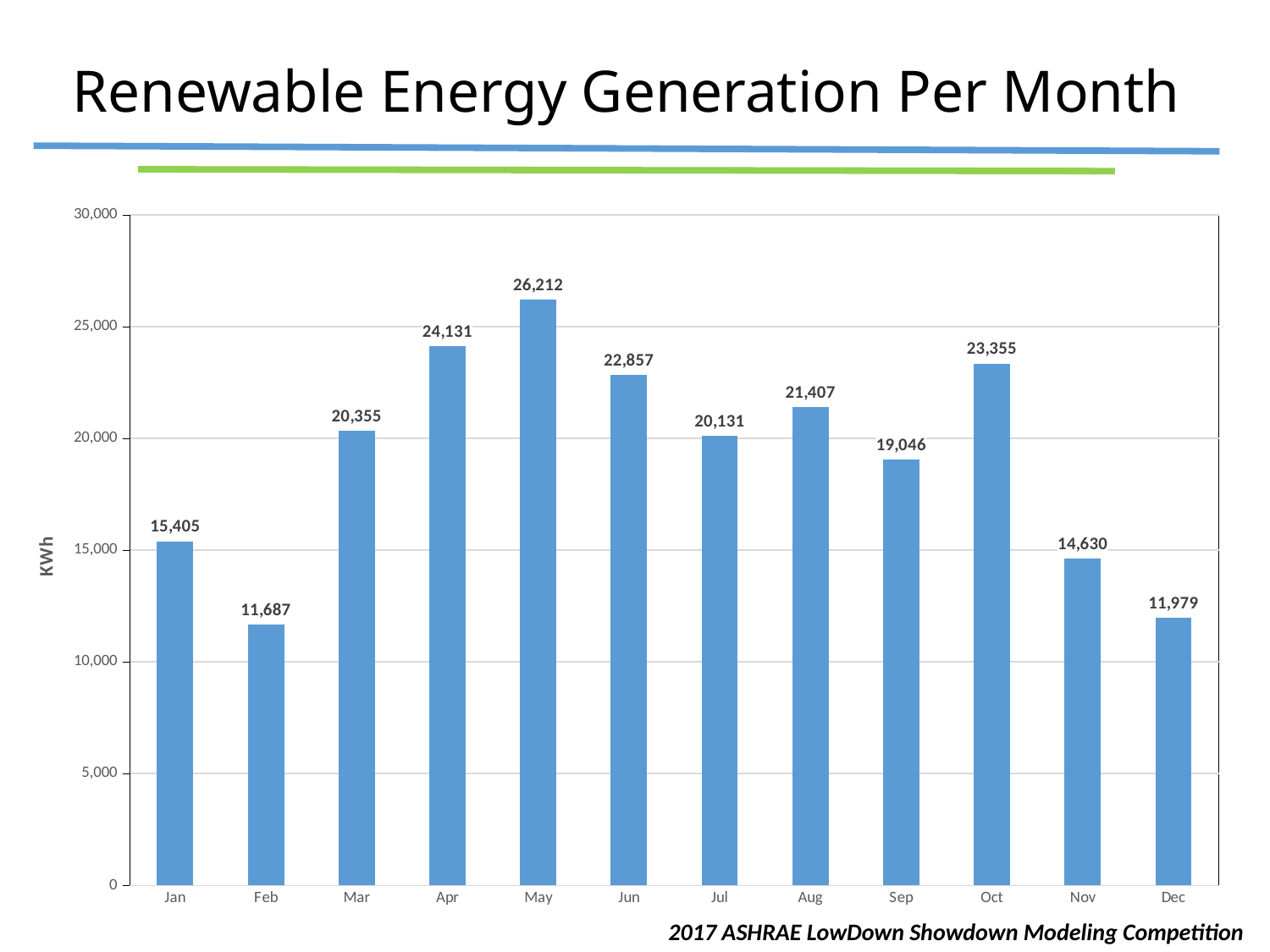
What is the difference between the values for Apr and Mar? 3,776 What is the difference between the values for May and Feb? 14,525 Which month has the highest renewable energy generation? May What is the label on the y axis? KWh Which month has the lowest renewable energy generation? Feb Is the value for Sep greater or less than 20,000? less What is the renewable energy generation for Feb? 11,687 What is the value shown for Oct? 23,355 How many months are shown on the x axis? 12 Which is larger, the value for Jun or the value for Aug? Jun What kind of chart is shown on the slide? bar chart What is the renewable energy generation for May? 26,212